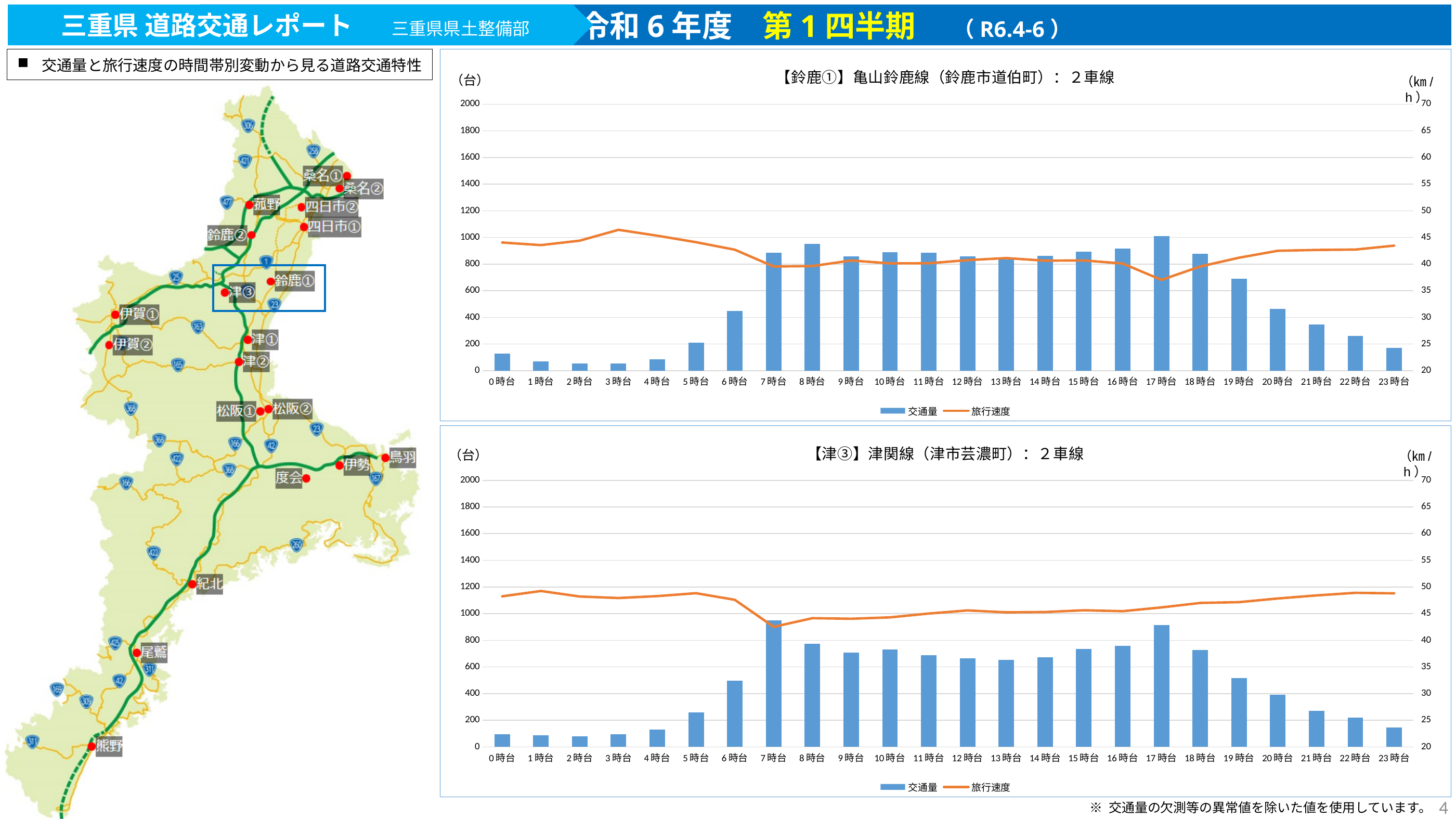
In the top chart (【鈴鹿①】亀山鈴鹿線), is the 交通量 value for 0時台 greater or less than 200? less In the top chart (【鈴鹿①】亀山鈴鹿線), do the 交通量 bars rise or fall from 17時台 to 23時台? fall In the bottom chart (【津③】津関線), is the 交通量 value for 7時台 greater or less than 800? greater In the bottom chart (【津③】津関線), is the 交通量 value for 23時台 greater or less than 200? less In the top chart (【鈴鹿①】亀山鈴鹿線), which hour has the highest 交通量 bar? 17時台 In the top chart (【鈴鹿①】亀山鈴鹿線), which has the larger 交通量 bar, 16時台 or 19時台? 16時台 In the bottom chart (【津③】津関線), which has the larger 交通量 bar, 17時台 or 18時台? 17時台 How many hourly categories are shown on the x axis of the top chart (【鈴鹿①】亀山鈴鹿線)? 24 What kind of chart is the bottom chart (【津③】津関線)? A bar chart combined with a line chart How many series does the legend of the bottom chart (【津③】津関線) list? 2 What are the two legend entries in the top chart (【鈴鹿①】亀山鈴鹿線)? 交通量 and 旅行速度